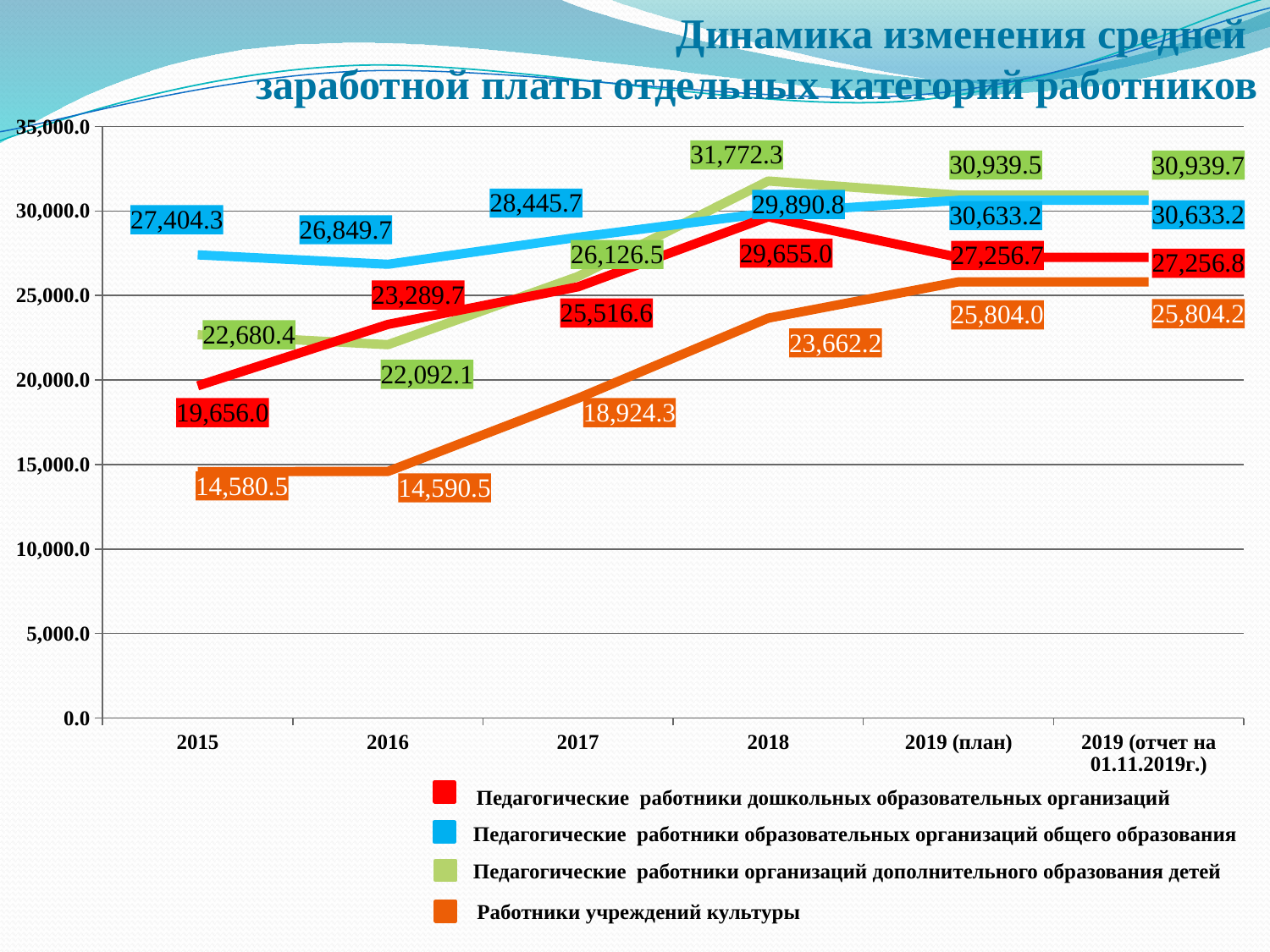
Which series has the higher value in 2017: Педагогические работники дошкольных образовательных организаций or Педагогические работники образовательных организаций общего образования? Педагогические работники образовательных организаций общего образования What is the difference between the 2018 values for Педагогические работники организаций дополнительного образования детей and Педагогические работники образовательных организаций общего образования? 1,881.5 In which year does the series Педагогические работники организаций дополнительного образования детей reach its highest value? 2018 What is the value for Педагогические работники дошкольных образовательных организаций in 2018? 29,655.0 What type of chart is shown on the slide? line chart How many categories are shown on the x axis? 6 What is the value for Работники учреждений культуры in 2015? 14,580.5 Do the values for Работники учреждений культуры rise or fall from 2015 to 2019 (план)? rise In which year is the value for Работники учреждений культуры lowest? 2015 What is the value for Педагогические работники образовательных организаций общего образования in 2016? 26,849.7 How many series does the legend list? 4 Which colour represents Работники учреждений культуры in the legend? orange